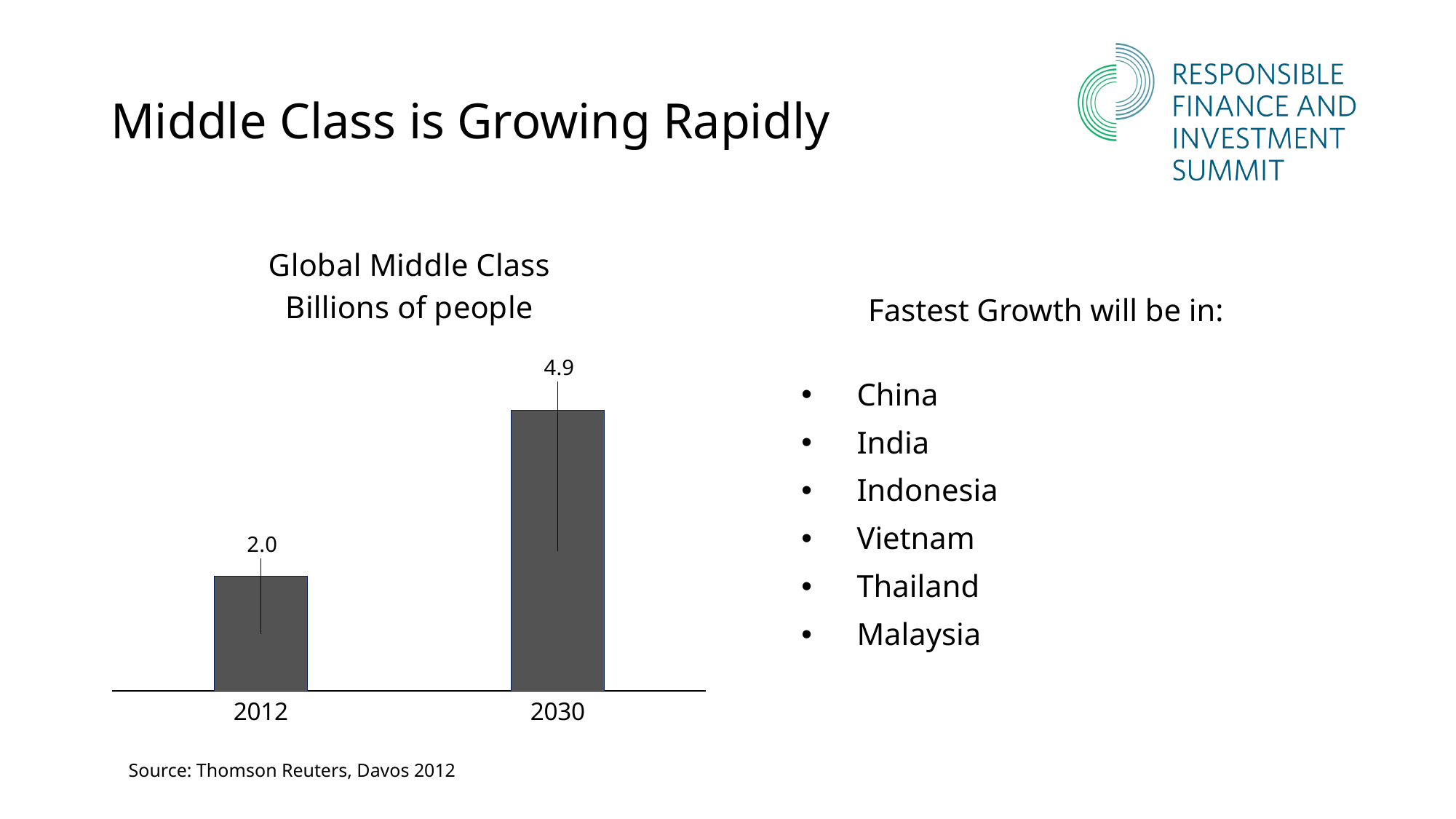
What kind of chart is used to show the Global Middle Class data? bar chart What is the value for 2030 in the Global Middle Class chart? 4.9 What is the source cited for the Global Middle Class chart? Thomson Reuters, Davos 2012 Do the values rise or fall from 2012 to 2030 in the Global Middle Class chart? rise Which year has the higher value in the Global Middle Class chart? 2030 Is the value for 2030 larger or smaller than the value for 2012? larger What is the difference between the 2030 and 2012 values in the Global Middle Class chart? 2.9 How many bars are shown in the Global Middle Class chart? 2 Which year has the lower value in the Global Middle Class chart? 2012 What unit is the Global Middle Class chart measured in, according to its title? Billions of people What is the value for 2012 in the Global Middle Class chart? 2.0